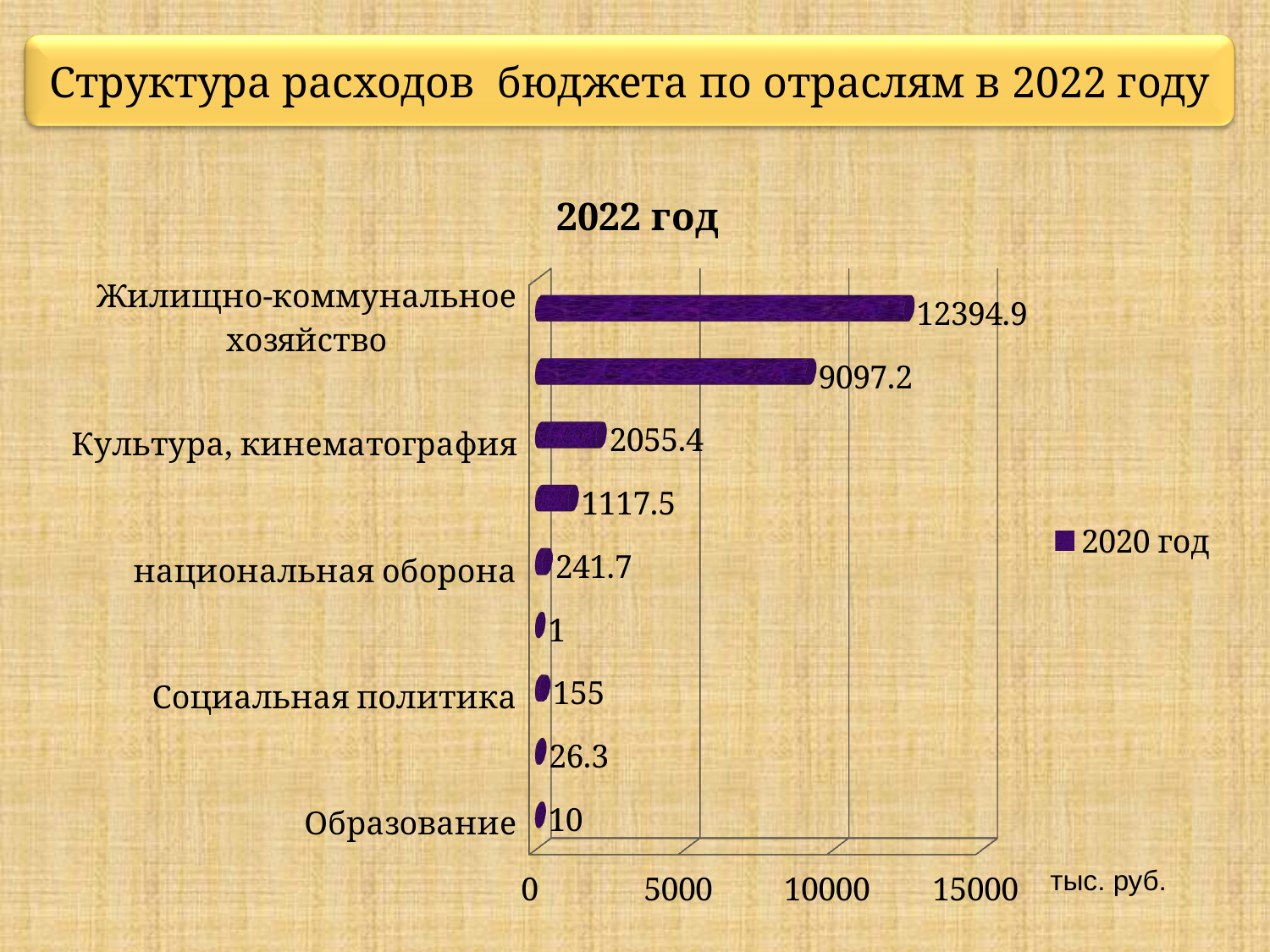
What kind of chart is shown? bar chart What is the value for Социальная политика? 155 What is the value for национальная оборона? 241.7 Is the value for Жилищно-коммунальное хозяйство greater or less than 10000? greater What entry does the legend list? 2020 год What is the value for Культура, кинематография? 2055.4 What is the value for Образование? 10 How many bars are plotted on the chart? 9 Which category has the highest value? Жилищно-коммунальное хозяйство What is the difference between the values for Жилищно-коммунальное хозяйство and Культура, кинематография? 10339.5 Which is larger, the value for Социальная политика or the value for Образование? Социальная политика What is the value for Жилищно-коммунальное хозяйство? 12394.9